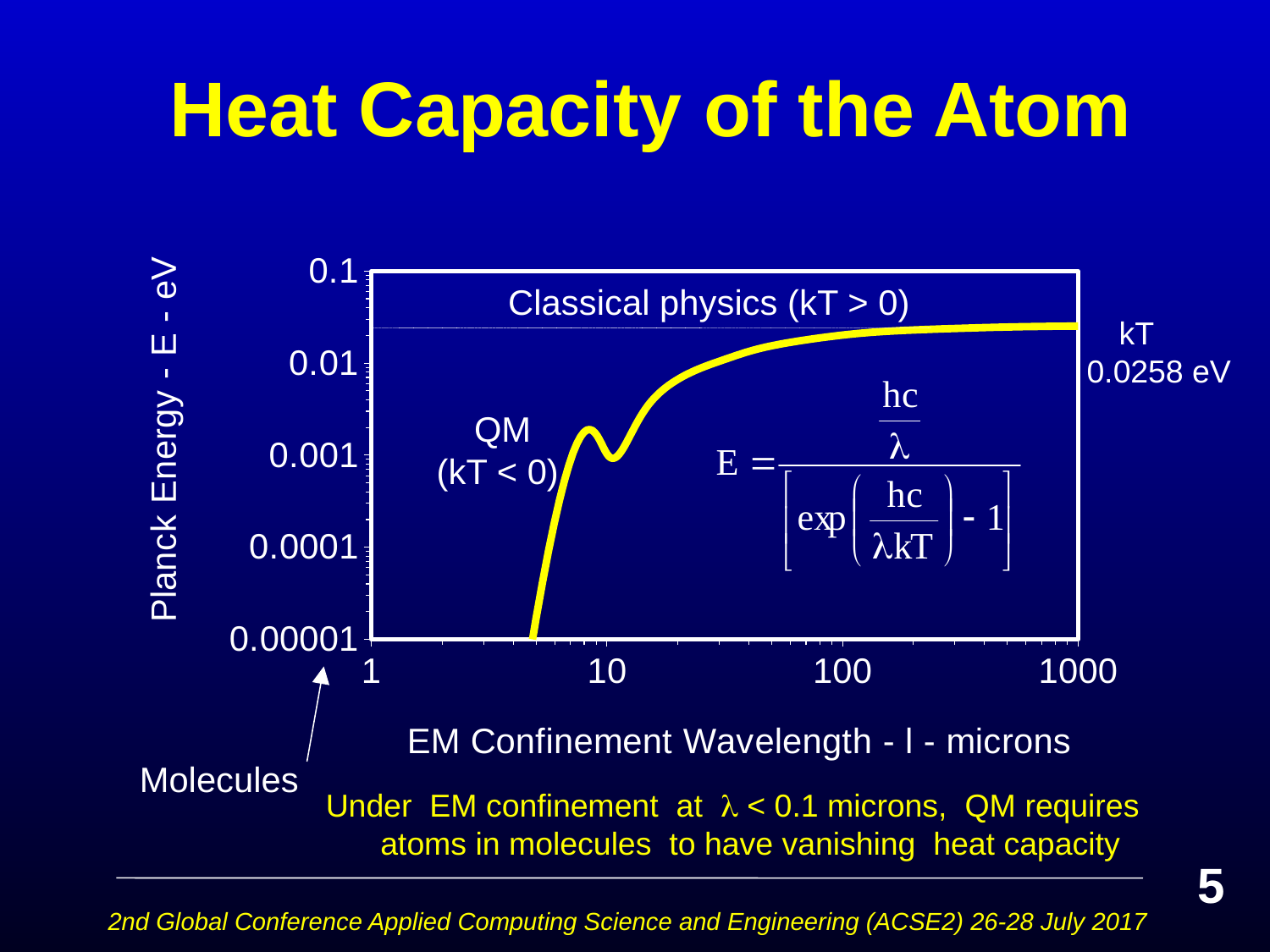
Is the Planck energy at a wavelength of 100 microns greater or less than 0.001 eV? greater How many curves are plotted on the chart? 1 What is the label of the vertical axis? Planck Energy - E - eV Is the Planck energy at a wavelength of 10 microns greater or less than 0.01 eV? less What is the label of the horizontal axis? EM Confinement Wavelength - l - microns What is the highest tick value shown on the vertical axis? 0.1 What is the value of kT labelled on the chart? 0.0258 eV Does the Planck energy curve generally rise or fall as the wavelength increases from 1 to 1000 microns? Rise What is the lowest tick value shown on the vertical axis? 0.00001 Is the Planck energy at a wavelength of 1000 microns greater or less than 0.01 eV? greater What is the largest wavelength value shown on the horizontal axis? 1000 What kind of chart is shown on the slide? Line chart